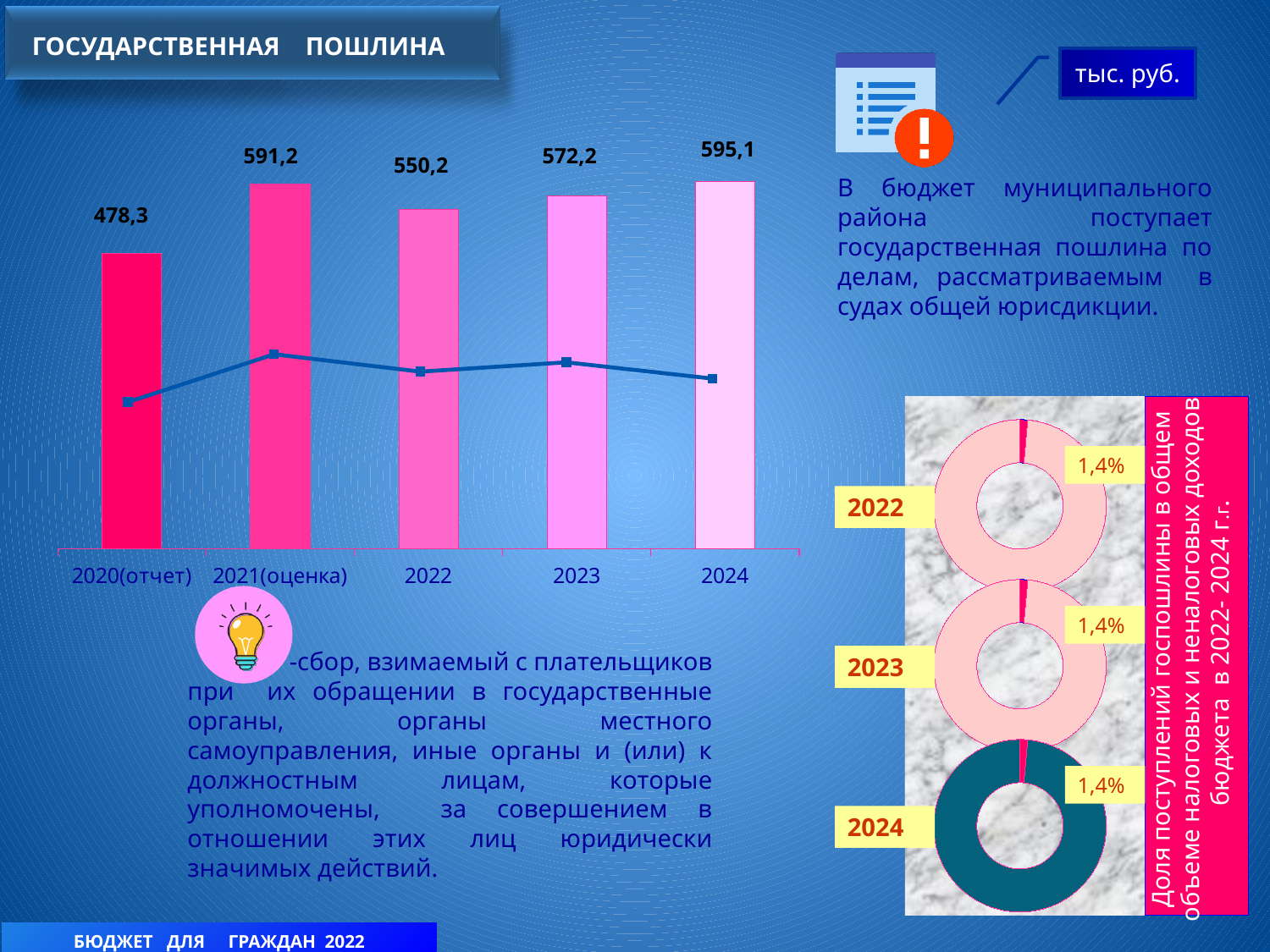
In the bar chart on the left, what is the difference between the values for 2024 and 2022? 44,9 In the bar chart on the left, which year has the highest value? 2024 In the bar chart on the left, what is the difference between the values for 2021(оценка) and 2020(отчет)? 112,9 What kind of chart is the chart on the left of the slide? bar chart In the bar chart on the left, do the values rise or fall from 2022 to 2024? rise In the bar chart on the left, what is the value for 2020(отчет)? 478,3 In the donut charts on the right, what share is shown for 2023? 1,4% How many years (categories) are shown in the bar chart on the left? 5 In the bar chart on the left, what is the value for 2022? 550,2 In the bar chart on the left, which year has the lowest value? 2020(отчет) In the bar chart on the left, which is larger, the value for 2023 or the value for 2022? 2023 In the bar chart on the left, what is the value for 2024? 595,1